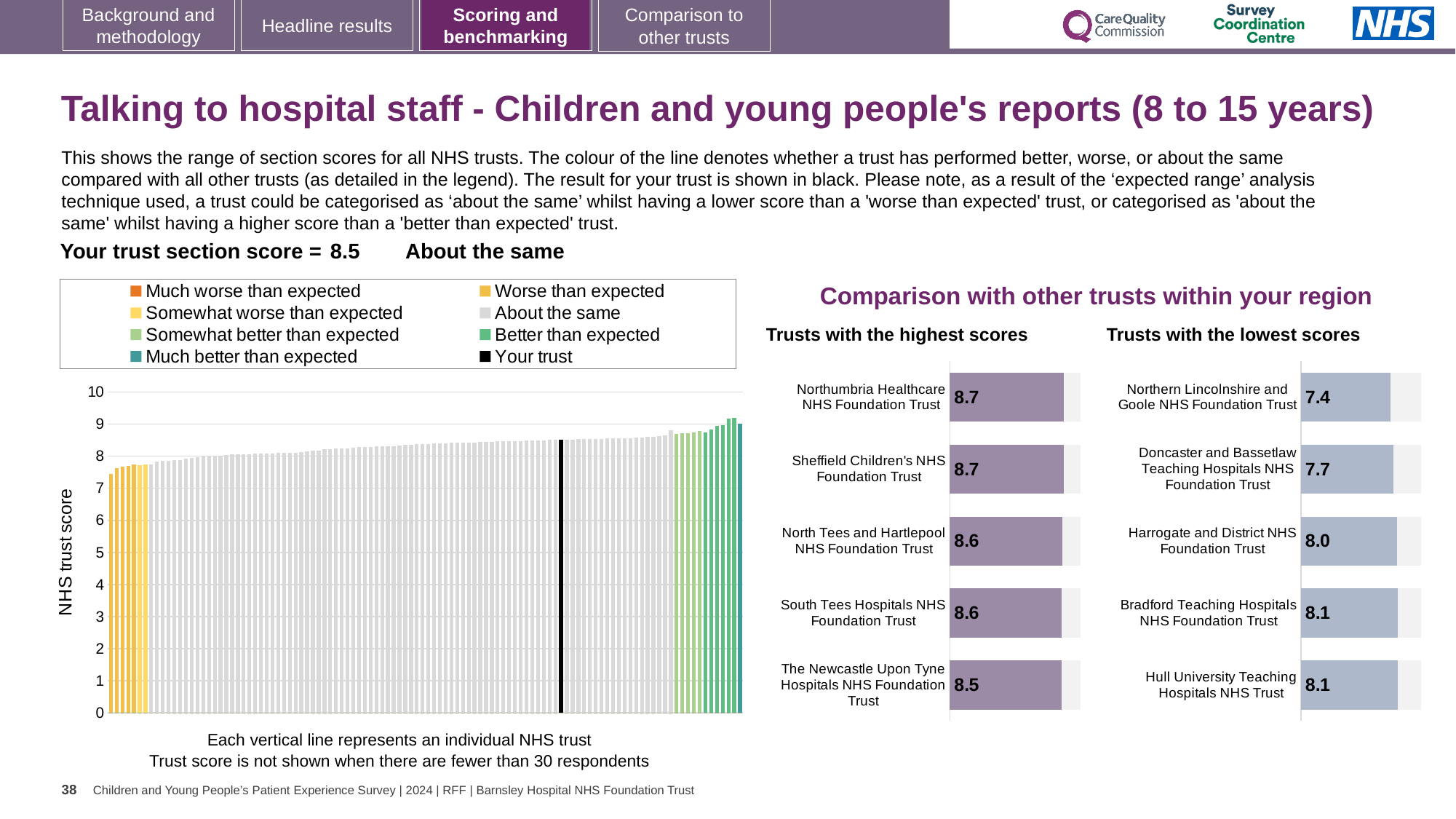
In the 'Trusts with the highest scores' chart, what is the score for The Newcastle Upon Tyne Hospitals NHS Foundation Trust? 8.5 What kind of chart is the main chart on the left showing NHS trust scores? Bar chart How many entries does the legend of the main NHS trust score chart list? 8 In the 'Trusts with the highest scores' chart, what is the score for Northumbria Healthcare NHS Foundation Trust? 8.7 What is the y-axis label of the main chart on the left? NHS trust score In the 'Trusts with the highest scores' chart, what is the difference between the scores of Northumbria Healthcare NHS Foundation Trust and The Newcastle Upon Tyne Hospitals NHS Foundation Trust? 0.2 In the 'Trusts with the lowest scores' chart, what is the difference between the scores of Hull University Teaching Hospitals NHS Trust and Northern Lincolnshire and Goole NHS Foundation Trust? 0.7 In the 'Trusts with the lowest scores' chart, which has the larger score: Harrogate and District NHS Foundation Trust or Doncaster and Bassetlaw Teaching Hospitals NHS Foundation Trust? Harrogate and District NHS Foundation Trust In the 'Trusts with the lowest scores' chart, what is the score for Harrogate and District NHS Foundation Trust? 8.0 In the 'Trusts with the lowest scores' chart, which trust has the lowest score? Northern Lincolnshire and Goole NHS Foundation Trust In the main NHS trust score chart, is the value of the black bar (your trust) greater or less than 8? greater How many trusts are shown in the 'Trusts with the lowest scores' chart? 5